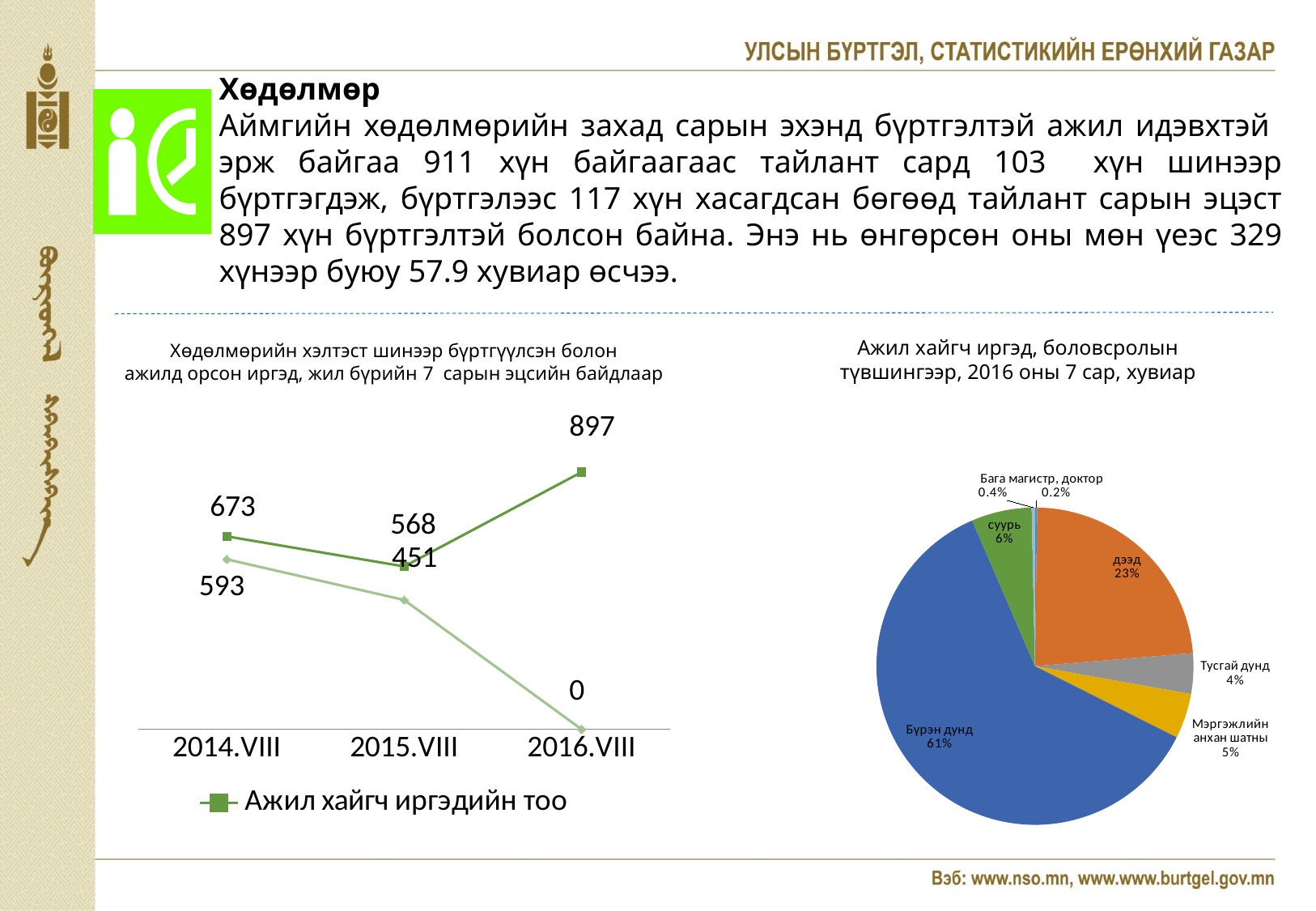
What type of chart is the chart on the left of the slide? Line chart In the pie chart on the right, what share does 'дээд' have? 23% In the line chart on the left, what is the value of 'Ажил хайгч иргэдийн тоо' for 2015.VIII? 568 In the line chart on the left, what is the value of 'Ажил хайгч иргэдийн тоо' for 2014.VIII? 673 In the line chart on the left, what is the difference between the 'Ажил хайгч иргэдийн тоо' values for 2016.VIII and 2015.VIII? 329 In the line chart on the left, in which period is 'Ажил хайгч иргэдийн тоо' highest? 2016.VIII In the pie chart on the right, which is larger, 'Тусгай дунд' or 'Мэргэжлийн анхан шатны'? Мэргэжлийн анхан шатны In the line chart on the left, how many series does the legend list? 1 In the line chart on the left, what is the value of 'Ажил хайгч иргэдийн тоо' for 2016.VIII? 897 In the pie chart on the right, what share does 'Бүрэн дунд' have? 61% In the line chart on the left, how many periods are shown on the x axis? 3 In the line chart on the left, in which period is 'Ажил хайгч иргэдийн тоо' lowest? 2015.VIII